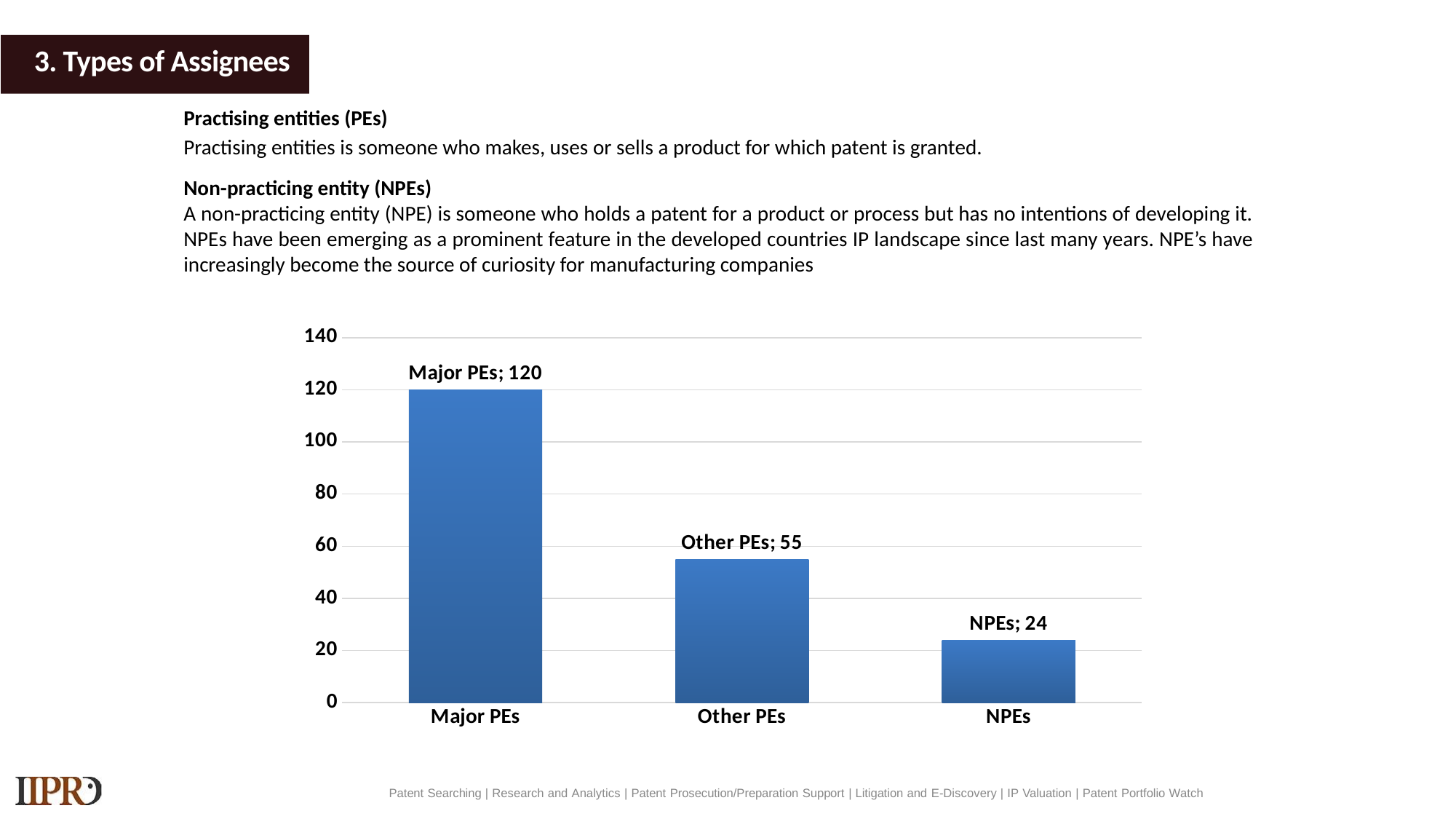
Which is larger, the value for Other PEs or the value for NPEs? Other PEs How many categories are shown in the chart? 3 What kind of chart is shown on the slide? bar chart Which category has the lowest value? NPEs What is the value for NPEs? 24 Is the value for Other PEs greater or less than 60? less What is the value for Major PEs? 120 Do the values rise or fall from left to right along the x axis? fall Which category has the highest value? Major PEs What is the difference between the values for Other PEs and NPEs? 31 What is the difference between the values for Major PEs and Other PEs? 65 What is the value for Other PEs? 55